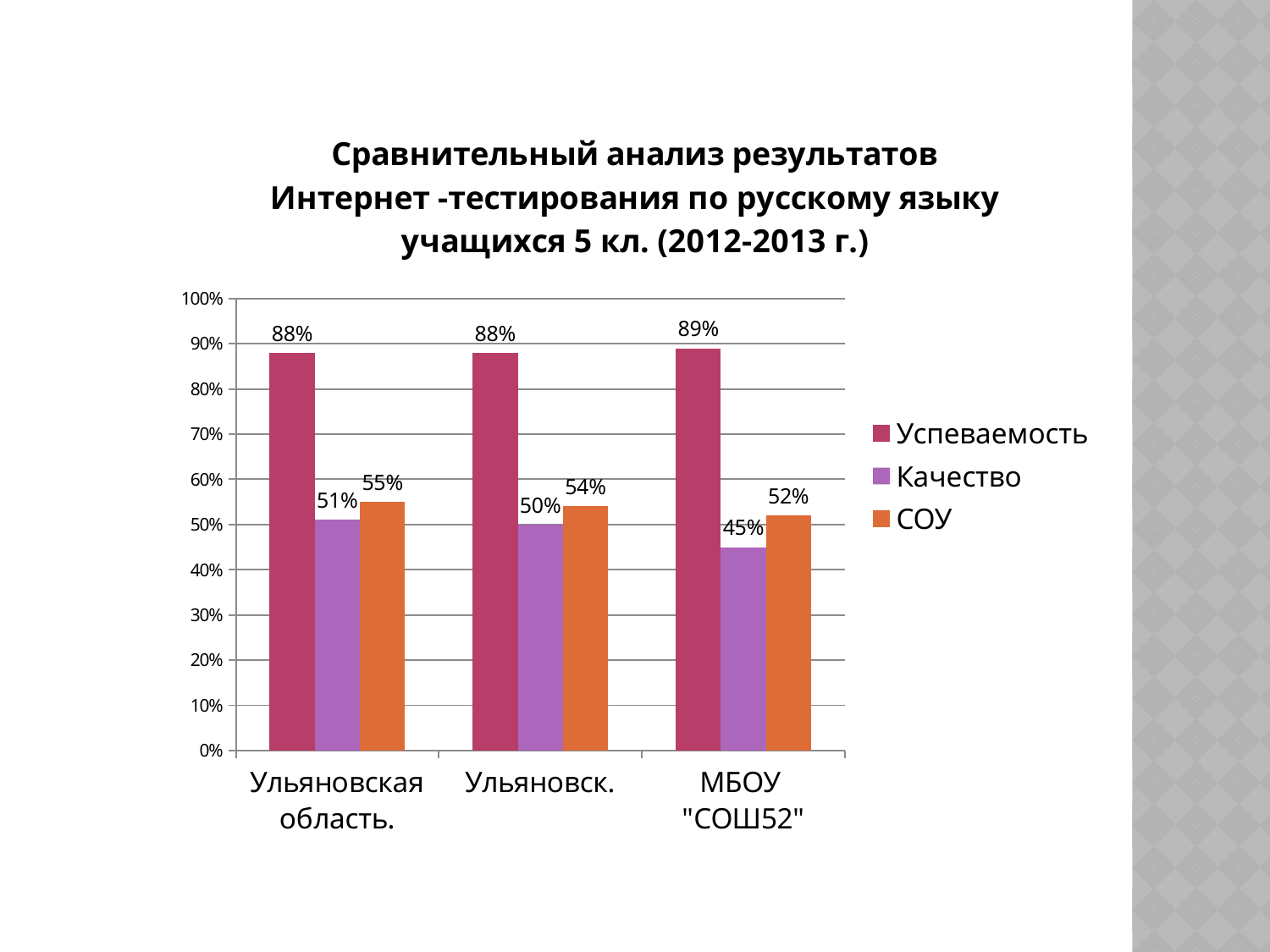
What is the Качество value for Ульяновская область.? 51% How many categories are shown on the x axis? 3 Which category has the lowest Качество value? МБОУ "СОШ52" Which is larger: the Качество value for Ульяновск. or the Качество value for МБОУ "СОШ52"? Ульяновск. What is the СОУ value for Ульяновск.? 54% What kind of chart is shown on the slide? bar chart Which category has the highest СОУ value? Ульяновская область. Is the Качество value for МБОУ "СОШ52" greater or less than 50%? less How many series does the legend list? 3 What is the Успеваемость value for МБОУ "СОШ52"? 89% Which series is shown in orange in the legend? СОУ What is the difference between the СОУ and Качество values for МБОУ "СОШ52"? 7%